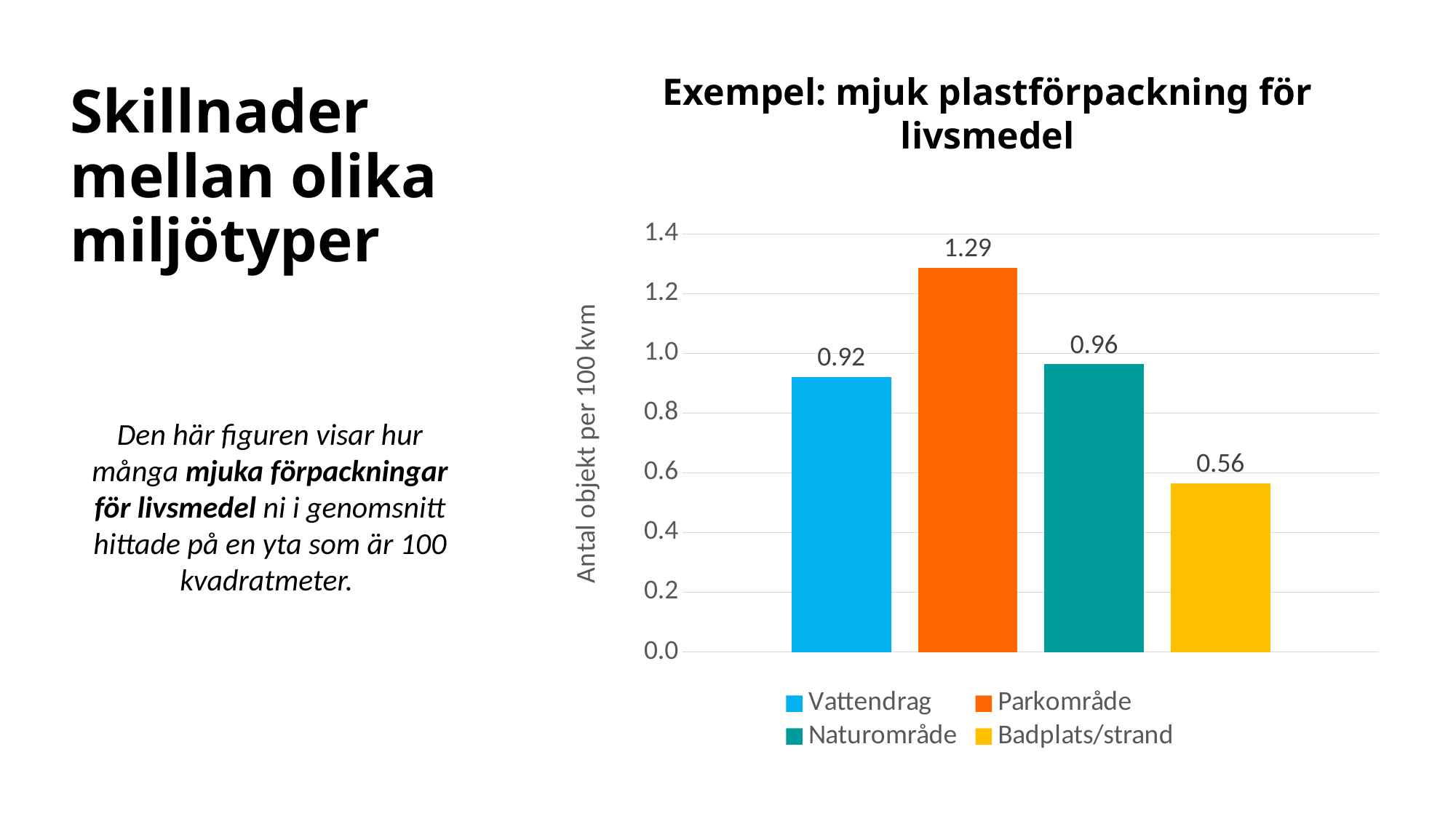
Which category has the highest value? Parkområde How many bars are shown in the chart? 4 What is the title of the chart? Exempel: mjuk plastförpackning för livsmedel What kind of chart is shown on the slide? bar chart Which is larger, the value for Naturområde or the value for Vattendrag? Naturområde Is the value for Parkområde greater or less than 1.2? greater What is the value for Parkområde? 1.29 What is the value for Vattendrag? 0.92 What is the value for Badplats/strand? 0.56 Which category has the lowest value? Badplats/strand What is the value for Naturområde? 0.96 What is the difference between the values for Parkområde and Badplats/strand? 0.73